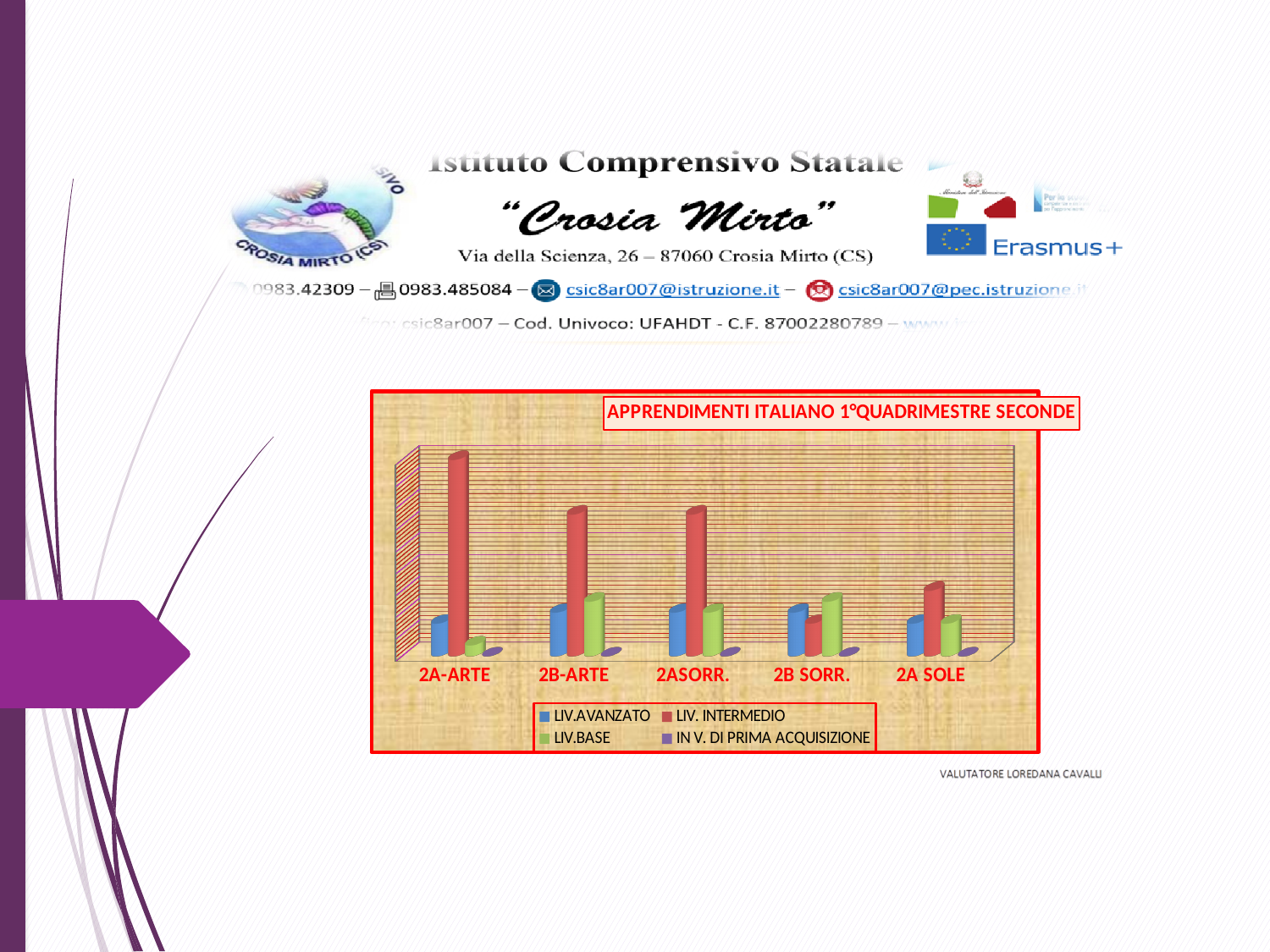
What kind of chart is shown on the slide? bar chart What is the title of the chart? APPRENDIMENTI ITALIANO 1°QUADRIMESTRE SECONDE In 2A-ARTE, which is larger: LIV.AVANZATO or LIV.BASE? LIV.AVANZATO Which series is shown in red in the chart? LIV. INTERMEDIO Which class has the lowest LIV. INTERMEDIO bar? 2B SORR. In 2B SORR., which is larger: LIV.BASE or LIV. INTERMEDIO? LIV.BASE Is the LIV. INTERMEDIO bar larger for 2A-ARTE or for 2B-ARTE? 2A-ARTE Which class has the highest LIV. INTERMEDIO bar? 2A-ARTE How many series does the chart's legend list? 4 How many categories (classes) are shown on the x axis of the chart? 5 Which class has the lowest LIV.BASE bar? 2A-ARTE Which series has the tallest bar in 2A SOLE? LIV. INTERMEDIO